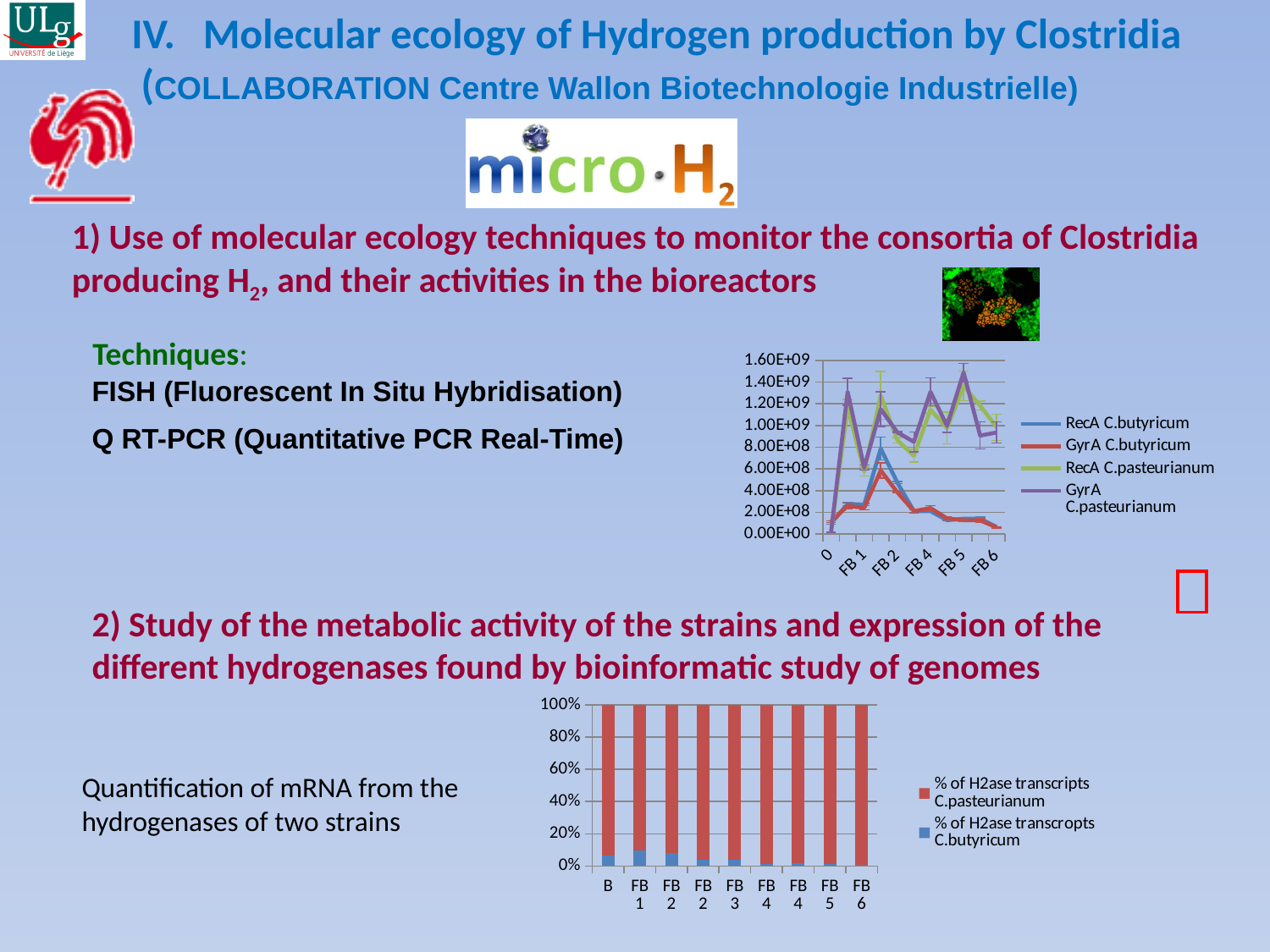
What kind of chart is the bottom chart on the slide? bar chart How many series does the legend of the bottom bar chart list? 2 In the bottom bar chart, is the share of H2ase transcripts of C.butyricum for FB 1 greater or less than 20%? less In the top-right line chart, is the value of GyrA C.butyricum at FB 6 greater or less than 2.00E+08? less How many bars are shown in the bottom bar chart? 9 In the bottom bar chart, is the share of H2ase transcripts of C.pasteurianum for B greater or less than 80%? greater How many series does the legend of the top-right line chart list? 4 In the top-right line chart, does the GyrA C.butyricum series rise or fall from FB 2 to FB 6? fall In the bottom bar chart, for category B, which series has the larger share: C.pasteurianum or C.butyricum? C.pasteurianum What kind of chart is the top-right chart on the slide? line chart In the top-right line chart, at FB 1, which is larger: RecA C.pasteurianum or GyrA C.butyricum? RecA C.pasteurianum In the top-right line chart, which series is listed last in the legend? GyrA C.pasteurianum